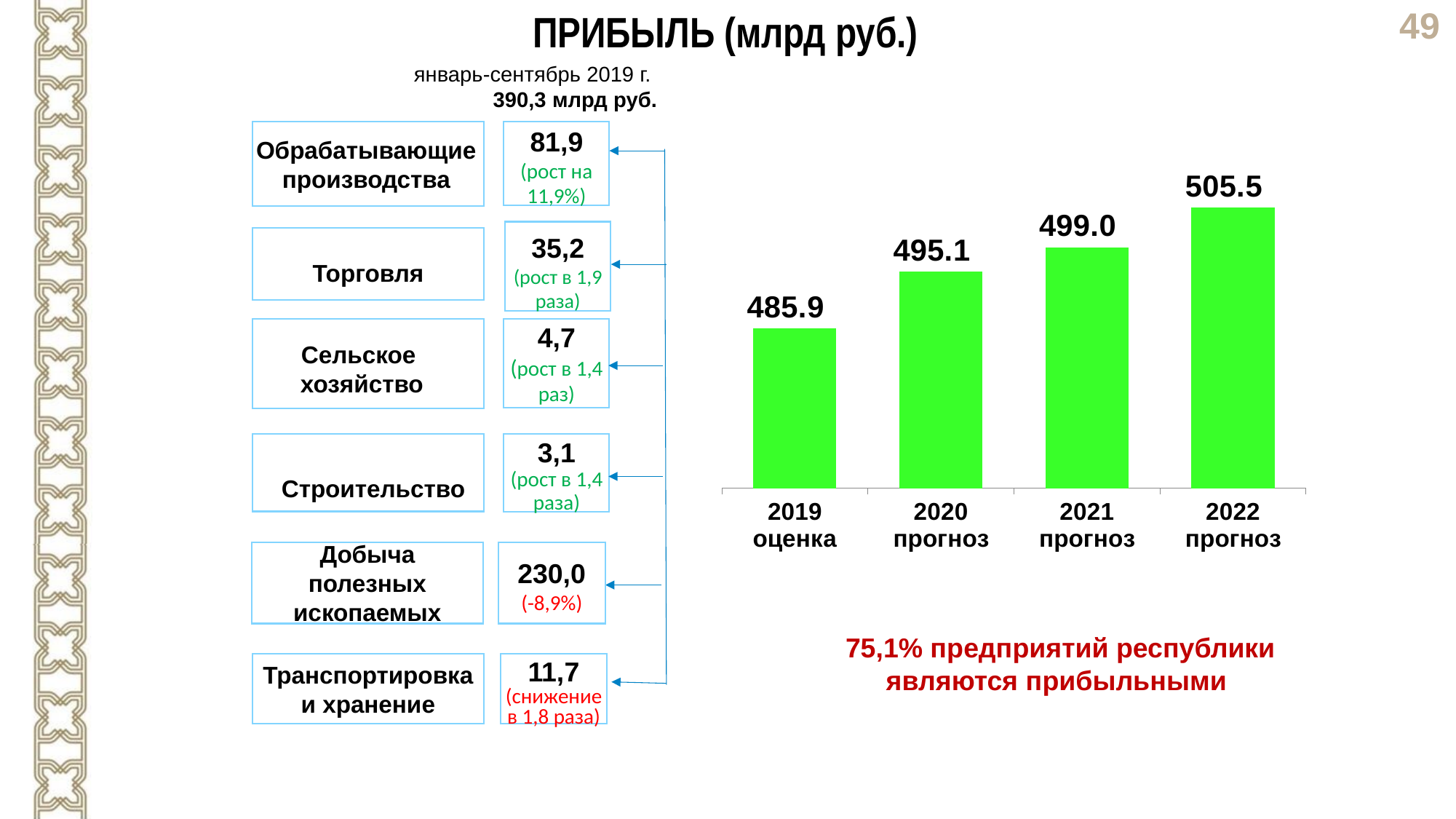
In the bar chart, what is the difference between the 2022 прогноз value and the 2019 оценка value? 19.6 In the bar chart, which year has the highest value? 2022 прогноз How many bars does the bar chart on the right contain? 4 In the bar chart, do the values rise or fall from 2019 to 2022? rise What type of chart is shown on the right side of the slide? bar chart In the bar chart, which year has the lowest value? 2019 оценка In the bar chart, what is the value for 2022 прогноз? 505.5 In the bar chart, what is the difference between the 2021 прогноз value and the 2020 прогноз value? 3.9 In the bar chart, what is the value for 2021 прогноз? 499.0 What colour are the bars in the bar chart? green In the bar chart, what is the value for 2019 оценка? 485.9 In the bar chart, what is the value for 2020 прогноз? 495.1